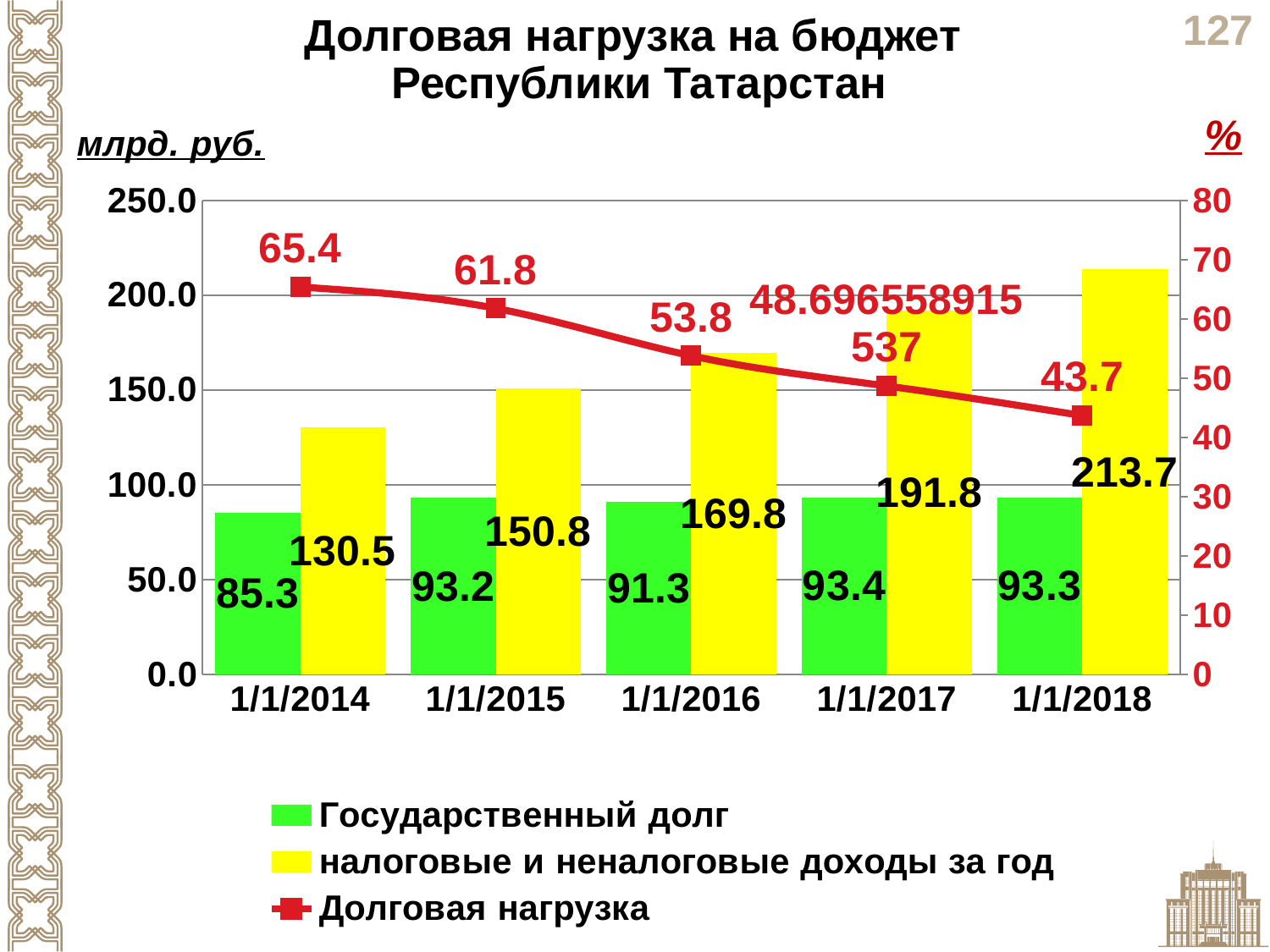
How many dates are shown on the x axis? 5 On which date is Государственный долг the lowest? 1/1/2014 What kind of chart is shown on the slide? A combined bar and line chart Which is larger: Государственный долг on 1/1/2015 or on 1/1/2016? 1/1/2015 On which date are налоговые и неналоговые доходы за год the highest? 1/1/2018 What is the value of налоговые и неналоговые доходы за год on 1/1/2018? 213.7 What is the value of Государственный долг on 1/1/2014? 85.3 How many series does the legend list? 3 What is the Долговая нагрузка value on 1/1/2015? 61.8 By how much did налоговые и неналоговые доходы за год increase from 1/1/2014 to 1/1/2018? 83.2 Does the Долговая нагрузка line rise or fall from 1/1/2014 to 1/1/2018? It falls What is the Долговая нагрузка value on 1/1/2018? 43.7